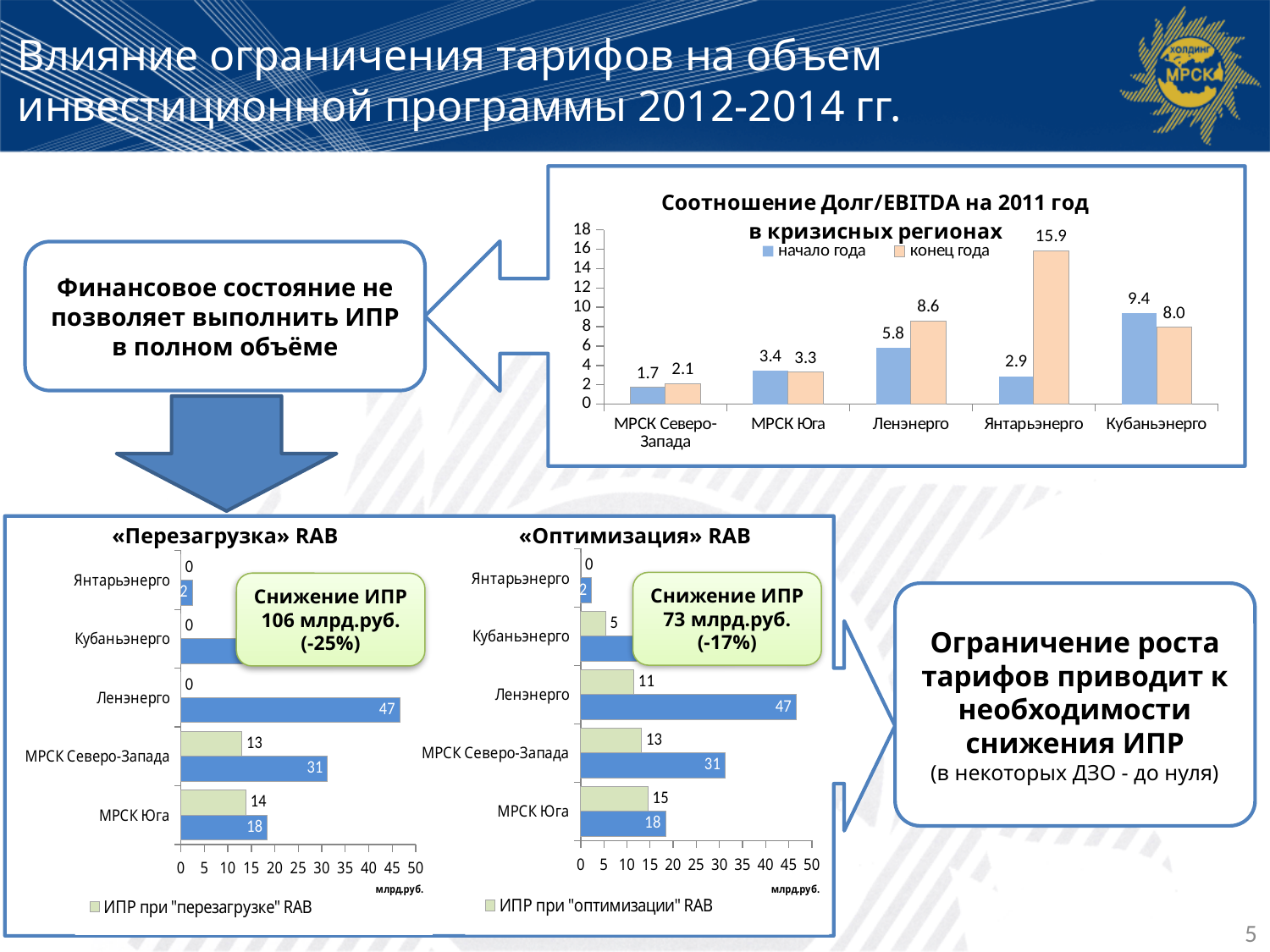
In the chart '«Перезагрузка» RAB', what is the value of the green bar (ИПР при "перезагрузке" RAB) for МРСК Юга? 14 In the chart '«Оптимизация» RAB', what is the difference between the blue bar and the green bar for МРСК Северо-Запада? 18 What type of chart is '«Перезагрузка» RAB'? bar chart In the chart 'Соотношение Долг/EBITDA на 2011 год в кризисных регионах', which company has the lowest start-of-year (начало года) value? МРСК Северо-Запада In the chart 'Соотношение Долг/EBITDA на 2011 год в кризисных регионах', how many series does the legend list? 2 In the chart 'Соотношение Долг/EBITDA на 2011 год в кризисных регионах', which company has the highest end-of-year (конец года) value? Янтарьэнерго In the chart 'Соотношение Долг/EBITDA на 2011 год в кризисных регионах', is the start-of-year value for Кубаньэнерго larger or smaller than its end-of-year value? larger In the chart 'Соотношение Долг/EBITDA на 2011 год в кризисных регионах', what is the value for Янтарьэнерго at the end of the year (конец года)? 15.9 In the chart '«Оптимизация» RAB', what is the value of the green bar (ИПР при "оптимизации" RAB) for Ленэнерго? 11 In the chart 'Соотношение Долг/EBITDA на 2011 год в кризисных регионах', how many companies are shown on the x axis? 5 In the chart 'Соотношение Долг/EBITDA на 2011 год в кризисных регионах', what is the difference between the end-of-year and start-of-year values for Ленэнерго? 2.8 In the chart 'Соотношение Долг/EBITDA на 2011 год в кризисных регионах', what is the value for Кубаньэнерго at the start of the year (начало года)? 9.4